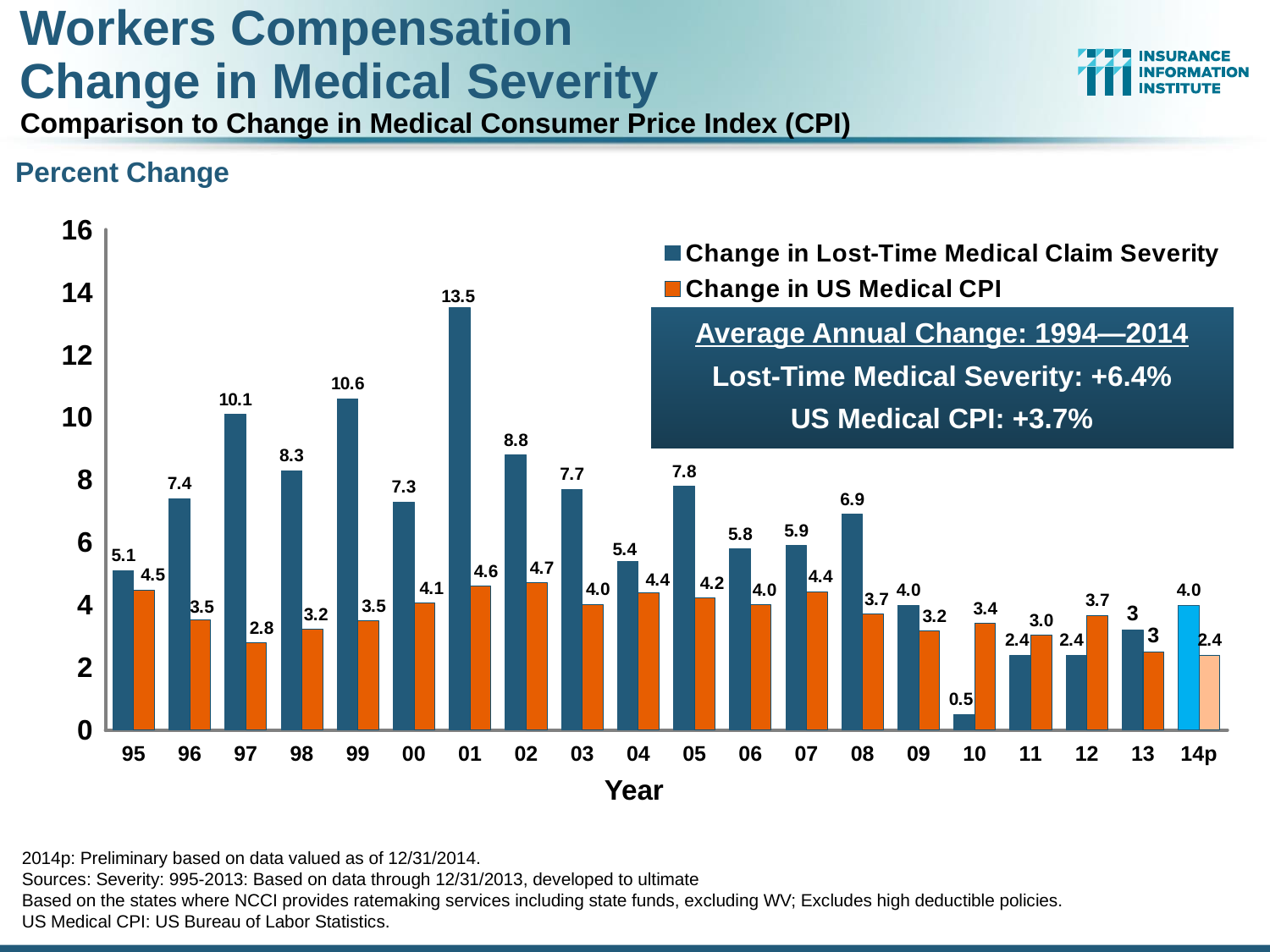
What kind of chart is shown on the slide? Bar chart In 10, which is larger: the Change in Lost-Time Medical Claim Severity or the Change in US Medical CPI? Change in US Medical CPI What is the difference between the Change in Lost-Time Medical Claim Severity and the Change in US Medical CPI in 01? 8.9 Which year has the lowest Change in Lost-Time Medical Claim Severity? 10 What is the Change in Lost-Time Medical Claim Severity for 01? 13.5 What is the Change in US Medical CPI for 02? 4.7 What is the Change in Lost-Time Medical Claim Severity for 14p? 4.0 How many years are shown on the x axis? 20 Does the Change in Lost-Time Medical Claim Severity rise or fall from 08 to 10? Fall Which year has the highest Change in Lost-Time Medical Claim Severity? 01 According to the text box on the chart, what is the average annual change in US Medical CPI for 1994—2014? +3.7% How many series does the legend list? 2